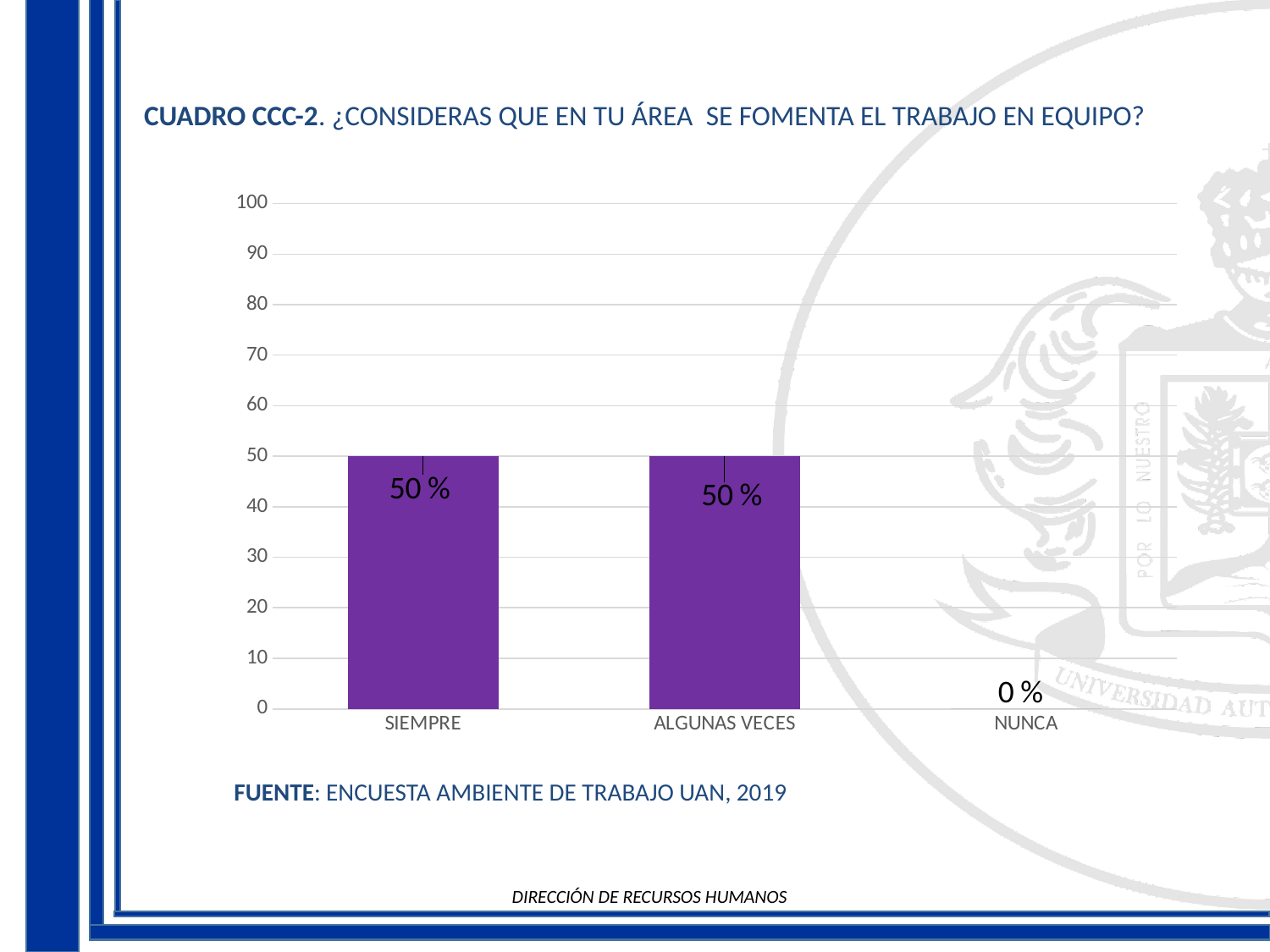
What is the value for SIEMPRE? 50 % Which is larger, the value for ALGUNAS VECES or the value for NUNCA? ALGUNAS VECES Is the value for ALGUNAS VECES greater or less than 40? greater Which category has the lowest value? NUNCA What is the value for ALGUNAS VECES? 50 % What is the highest value shown on the vertical axis? 100 Is the value for SIEMPRE greater or less than 60? less What is the difference between the values for SIEMPRE and NUNCA? 50 % What source is cited below the chart? ENCUESTA AMBIENTE DE TRABAJO UAN, 2019 What kind of chart is shown on the slide? bar chart How many categories are shown on the x axis? 3 What is the value for NUNCA? 0 %